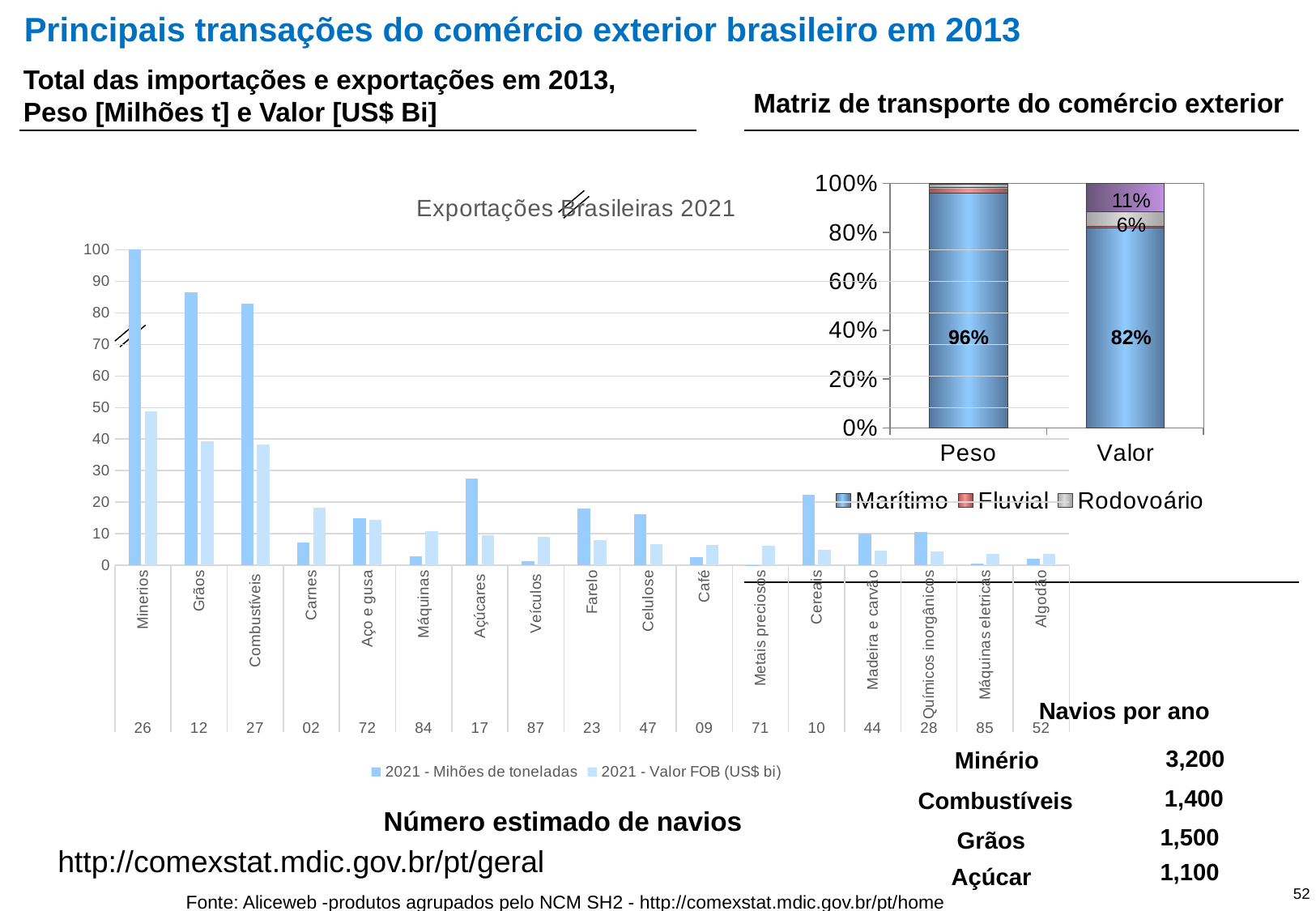
How many series does the legend of the 'Matriz de transporte do comércio exterior' chart list? 3 In the 'Matriz de transporte do comércio exterior' chart, which bar has the larger Marítimo share, Peso or Valor? Peso In the 'Exportações Brasileiras 2021' chart, is the '2021 - Mihões de toneladas' value for Grãos greater or less than 80? greater In the 'Matriz de transporte do comércio exterior' chart, what percentage is labelled for Marítimo in the Valor bar? 82% How many product categories are shown on the x axis of the 'Exportações Brasileiras 2021' chart? 17 In the 'Exportações Brasileiras 2021' chart, which category has the highest '2021 - Mihões de toneladas' value? Minerios What kind of chart is the 'Exportações Brasileiras 2021' chart on the left? Bar chart How many series does the legend of the 'Exportações Brasileiras 2021' chart list? 2 In the 'Matriz de transporte do comércio exterior' chart, what is the difference between the Marítimo share for Peso and for Valor? 14 percentage points In the 'Matriz de transporte do comércio exterior' chart, what percentage is labelled for Marítimo in the Peso bar? 96% In the 'Exportações Brasileiras 2021' chart, for Carnes, which is larger: the '2021 - Mihões de toneladas' bar or the '2021 - Valor FOB (US$ bi)' bar? 2021 - Valor FOB (US$ bi) In the 'Matriz de transporte do comércio exterior' chart, what percentage is labelled on the grey (Rodovoário) segment of the Valor bar? 6%